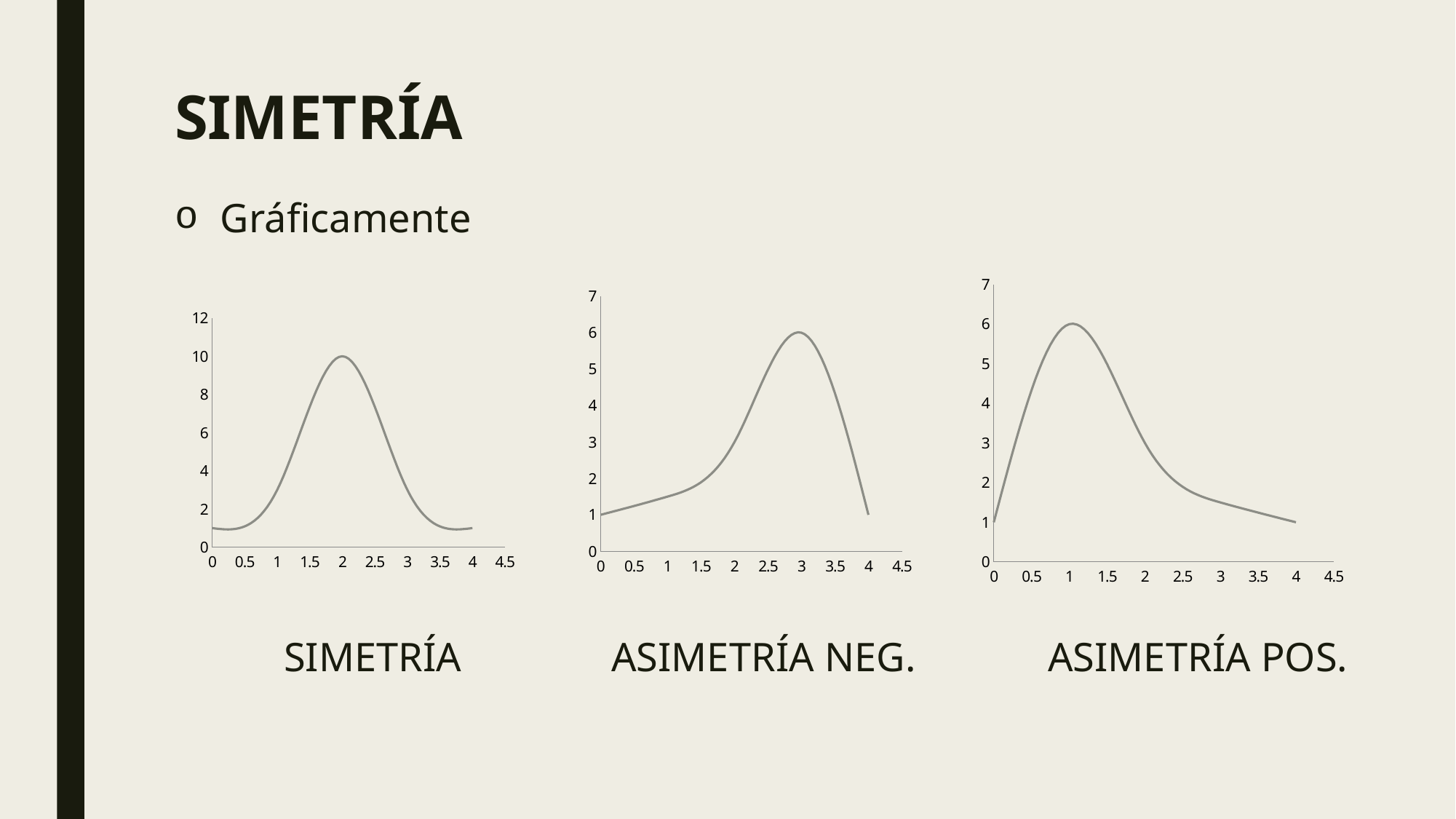
In the ASIMETRÍA NEG. chart, at which x value does the curve reach its peak? 3 What is the maximum value shown on the y axis of the SIMETRÍA chart? 12 In the SIMETRÍA chart, what is the peak value of the curve? 10 In the ASIMETRÍA NEG. chart, what is the peak value of the curve? 6 In the ASIMETRÍA NEG. chart, does the curve rise or fall between x = 0 and x = 3? rise In the ASIMETRÍA POS. chart, is the value at x = 2.5 greater or less than 3? less In the SIMETRÍA chart, at which x value does the curve reach its peak? 2 In the ASIMETRÍA NEG. chart, is the value at x = 2.5 greater or less than 4? greater How many charts are shown on the slide? 3 What kind of chart is the SIMETRÍA chart? line chart In the ASIMETRÍA POS. chart, at which x value does the curve reach its peak? 1 In the ASIMETRÍA POS. chart, does the curve rise or fall between x = 1 and x = 4? fall